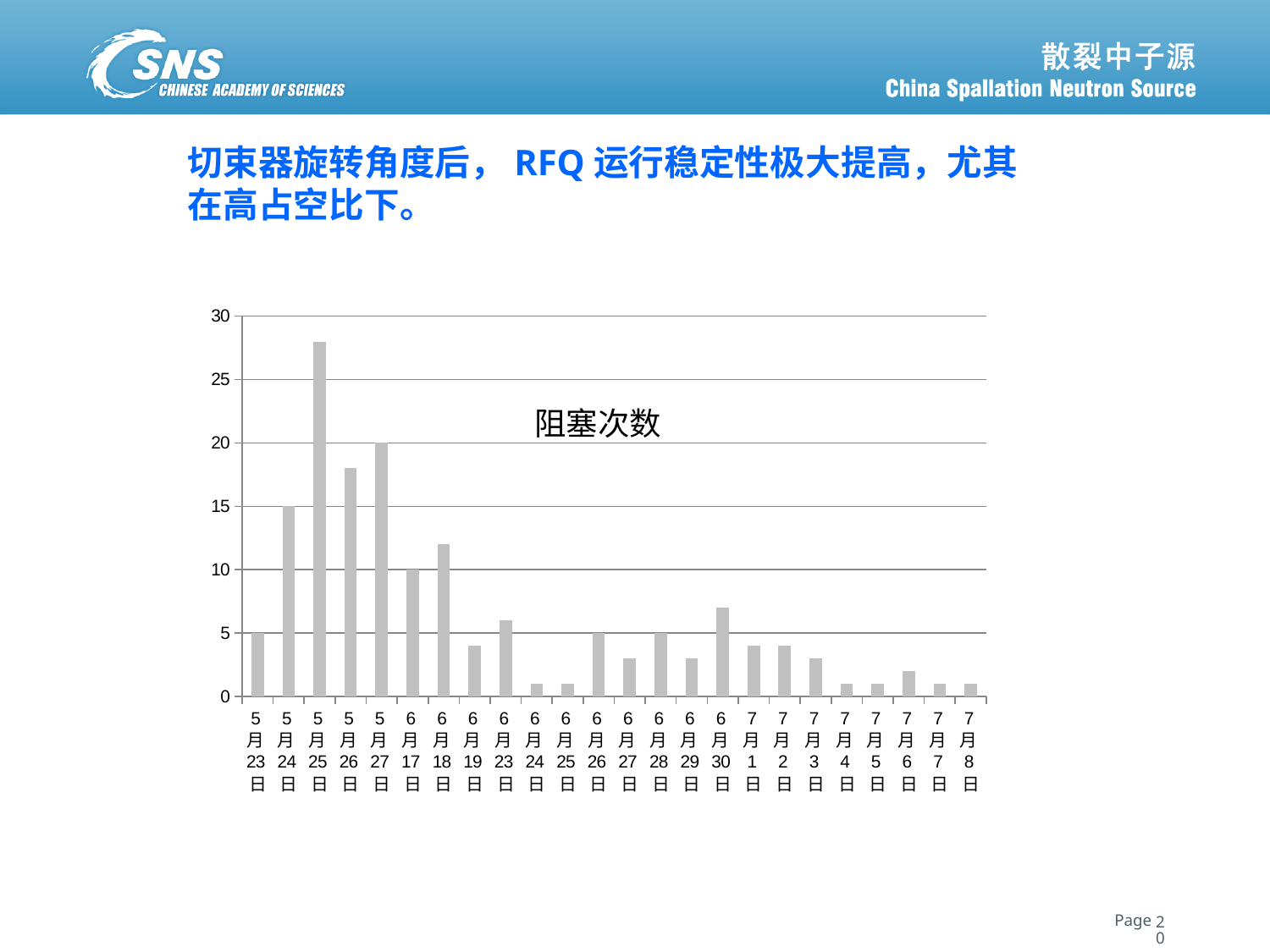
Which is larger, the value for 5月25日 or the value for 5月27日? 5月25日 How many dates (categories) are plotted on the x axis? 24 Is the value for 6月24日 greater or less than 5? less What is the value for 5月24日? 15 Is the value for 6月18日 greater or less than 10? greater Which date has the highest number of 阻塞次数? 5月25日 What is the difference between the values for 5月27日 and 5月24日? 5 What is the title of the chart? 阻塞次数 What is the value for 5月27日? 20 What is the value for 6月17日? 10 What kind of chart is shown on the slide? bar chart Is the value for 5月25日 greater or less than 25? greater